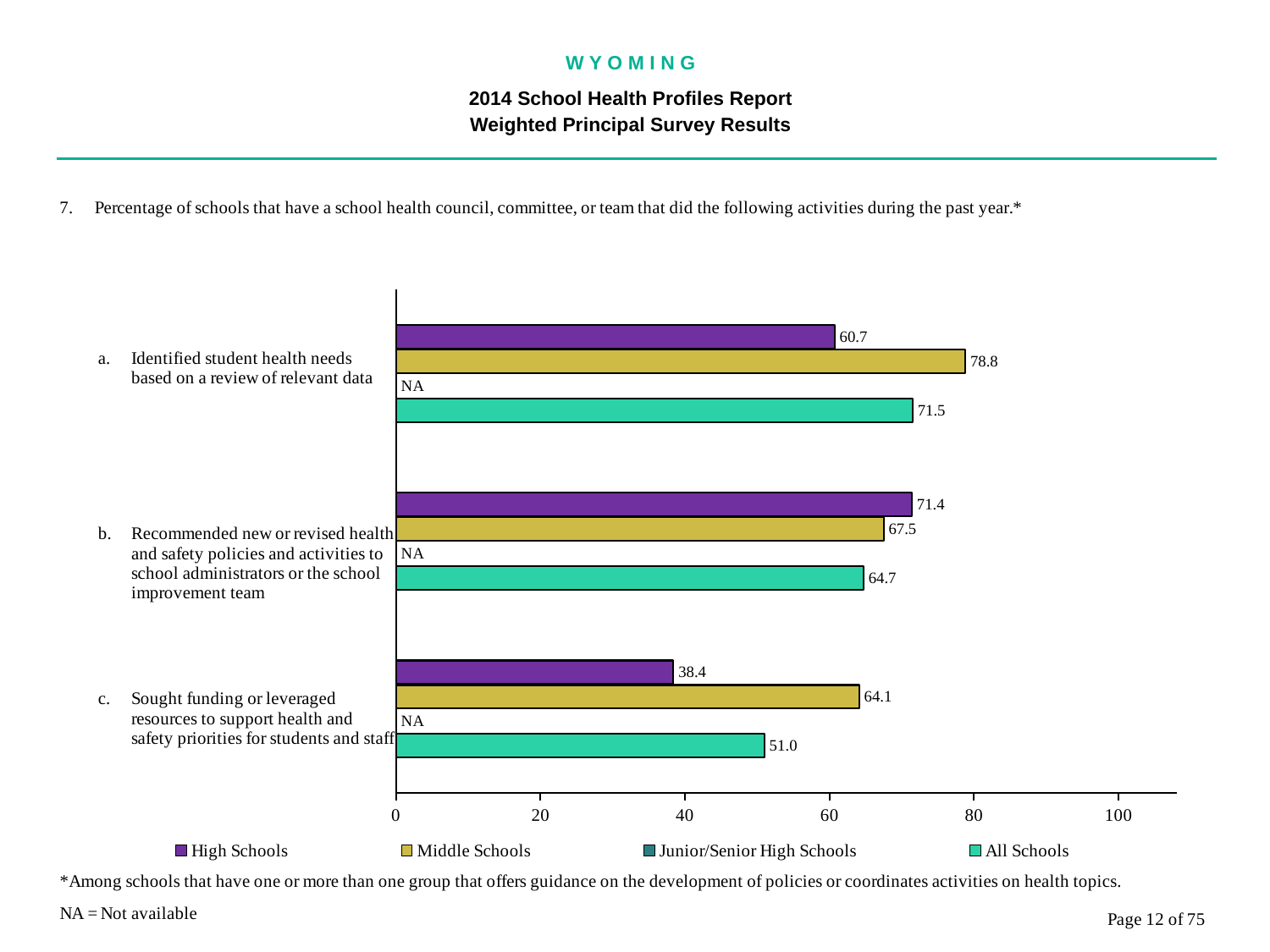
Which activity has the highest value for Middle Schools? a. Identified student health needs based on a review of relevant data What is the value for All Schools for activity b, recommended new or revised health and safety policies? 64.7 How many series does the legend list? 4 What is the difference between the Middle Schools and High Schools values for activity c? 25.7 How many activities (categories) are shown on the chart? 3 For activity b, which is larger: the High Schools value or the Middle Schools value? High Schools Which activity has the lowest value for High Schools? c. Sought funding or leveraged resources to support health and safety priorities for students and staff Is the All Schools value for activity c greater or less than 60? less What is the value for Middle Schools for activity c, sought funding or leveraged resources to support health and safety priorities? 64.1 What is the value for High Schools for activity a, identified student health needs based on a review of relevant data? 60.7 What kind of chart is shown on the slide? bar chart What value is shown for Junior/Senior High Schools for activity a? NA